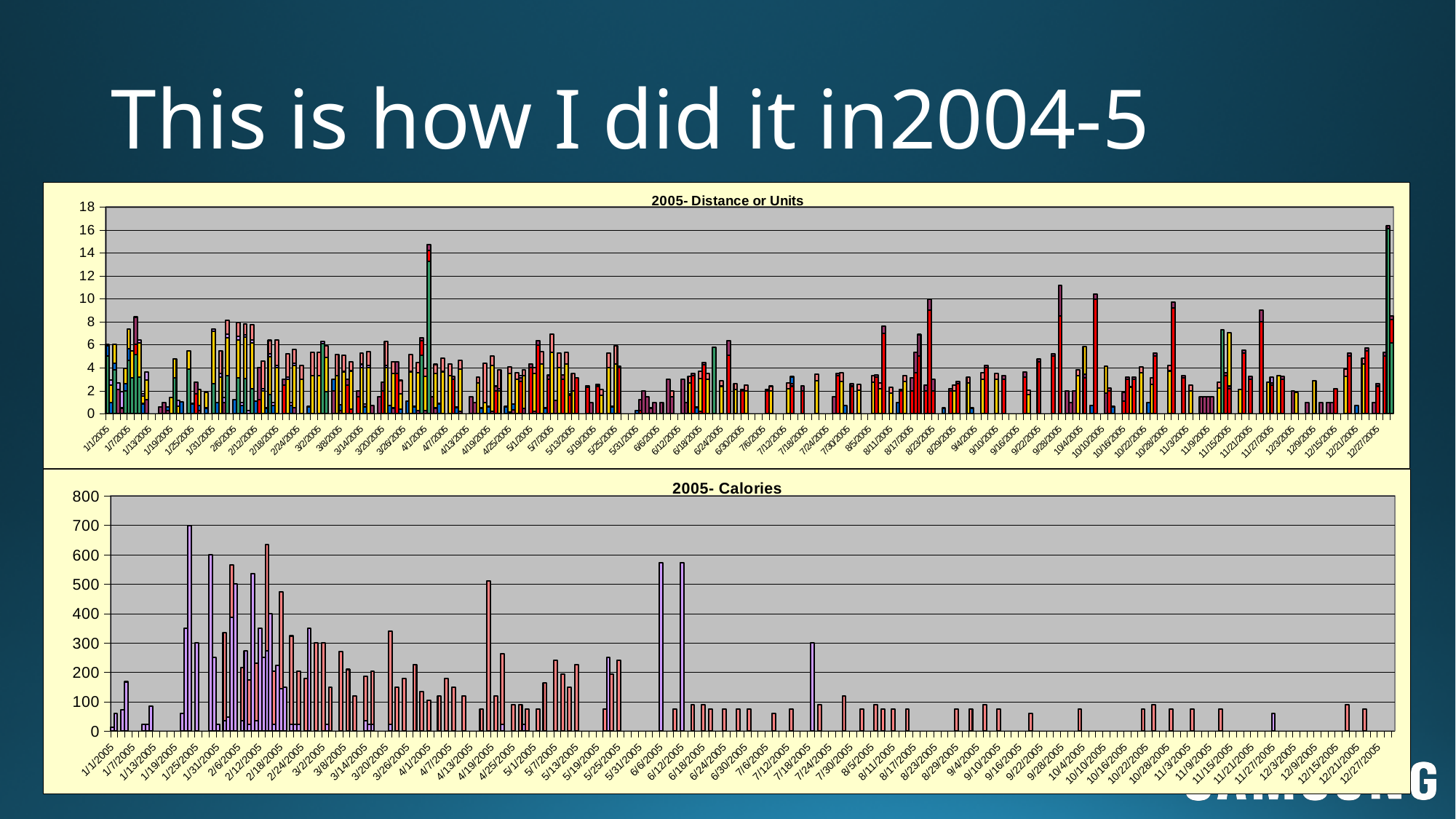
In the "2005- Distance or Units" chart, is the tall bar near 4/1/2005 greater or less than 12? greater What kind of chart is the top chart titled "2005- Distance or Units"? bar chart What is the title of the top chart on the slide? 2005- Distance or Units What is the title of the bottom chart on the slide? 2005- Calories In the "2005- Calories" chart, do the bar heights generally rise or fall from the start of the year to the end of the year? fall In the "2005- Calories" chart, which is larger: the tallest bar near 1/25/2005 or the tallest bar near 12/21/2005? the bar near 1/25/2005 What kind of chart is the bottom chart titled "2005- Calories"? bar chart In the "2005- Distance or Units" chart, is the bar near 9/28/2005 greater or less than 10? greater In the "2005- Calories" chart, is the tallest bar (near 1/25/2005) greater or less than 600? greater